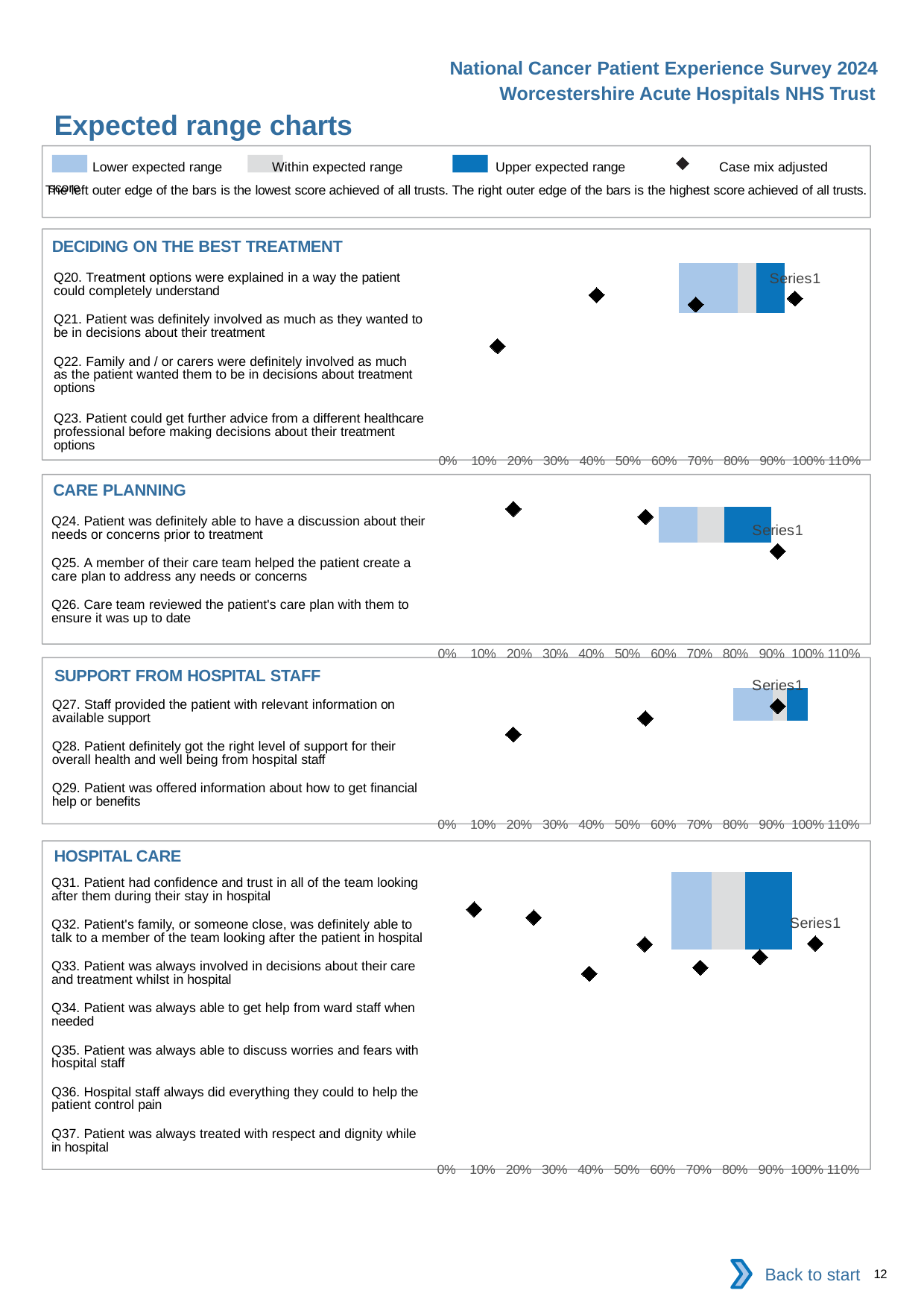
Which section chart lists the most questions? HOSPITAL CARE How many expected range charts are shown on the slide? 4 How many questions (categories) are listed in the SUPPORT FROM HOSPITAL STAFF chart? 3 How many questions (categories) are listed in the HOSPITAL CARE chart? 7 In the legend, what does the black diamond marker represent? Case mix adjusted score What kind of chart is used in the DECIDING ON THE BEST TREATMENT section? bar chart How many entries does the legend at the top of the slide list? 4 What is the highest tick label on the x axis of the HOSPITAL CARE chart? 110%